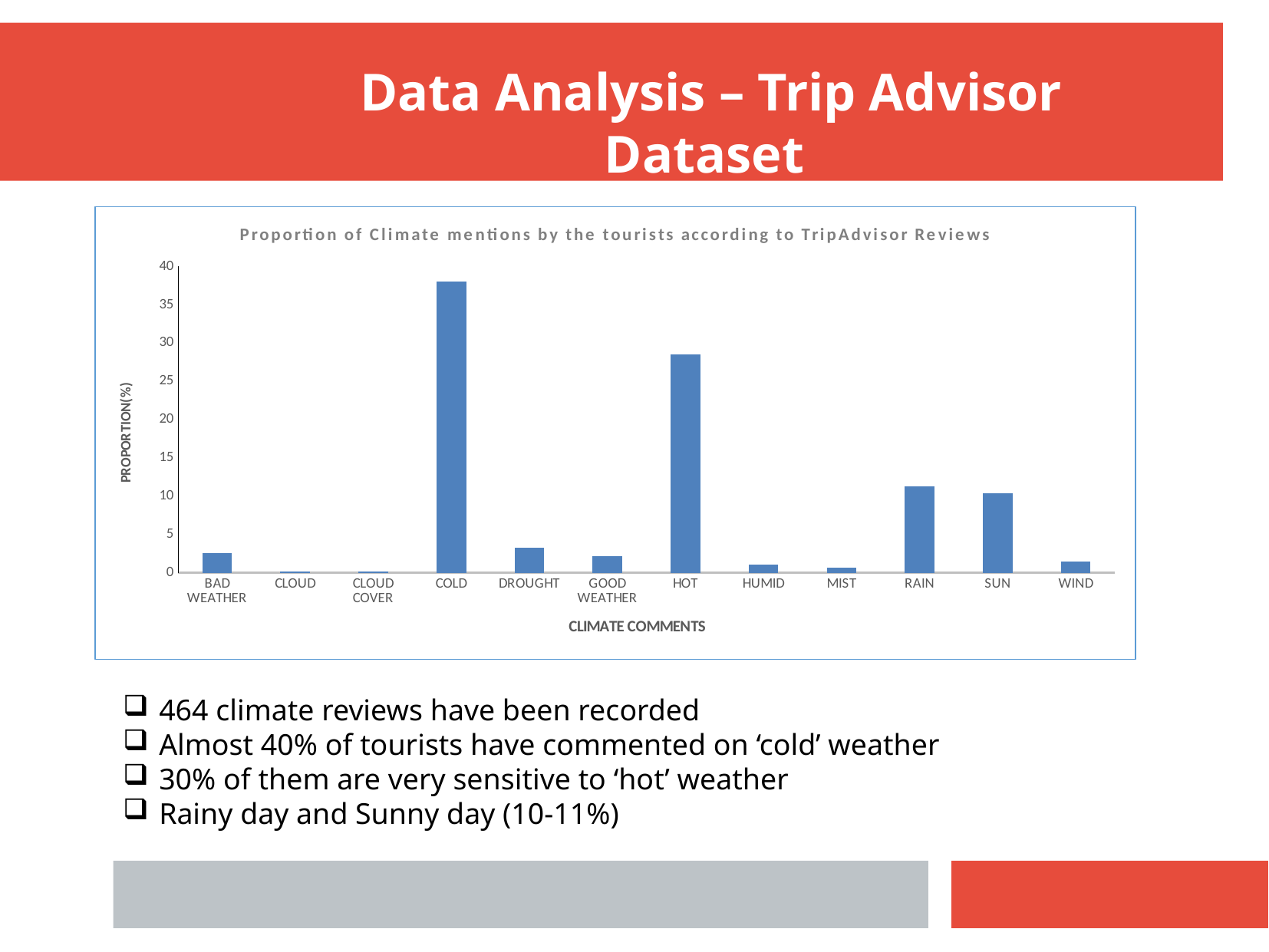
Is the value for HOT greater or less than 30? less What is the title of the chart? Proportion of Climate mentions by the tourists according to TripAdvisor Reviews What kind of chart is shown on the slide? bar chart How many climate comment categories are plotted on the x axis? 12 Is the value for HOT greater or less than 25? greater Which climate comment category has the highest proportion? COLD What is the label of the vertical axis of the chart? PROPORTION(%) Is the value for RAIN greater or less than 15? less Which has a larger proportion, COLD or HOT? COLD Which has a larger proportion, HOT or RAIN? HOT